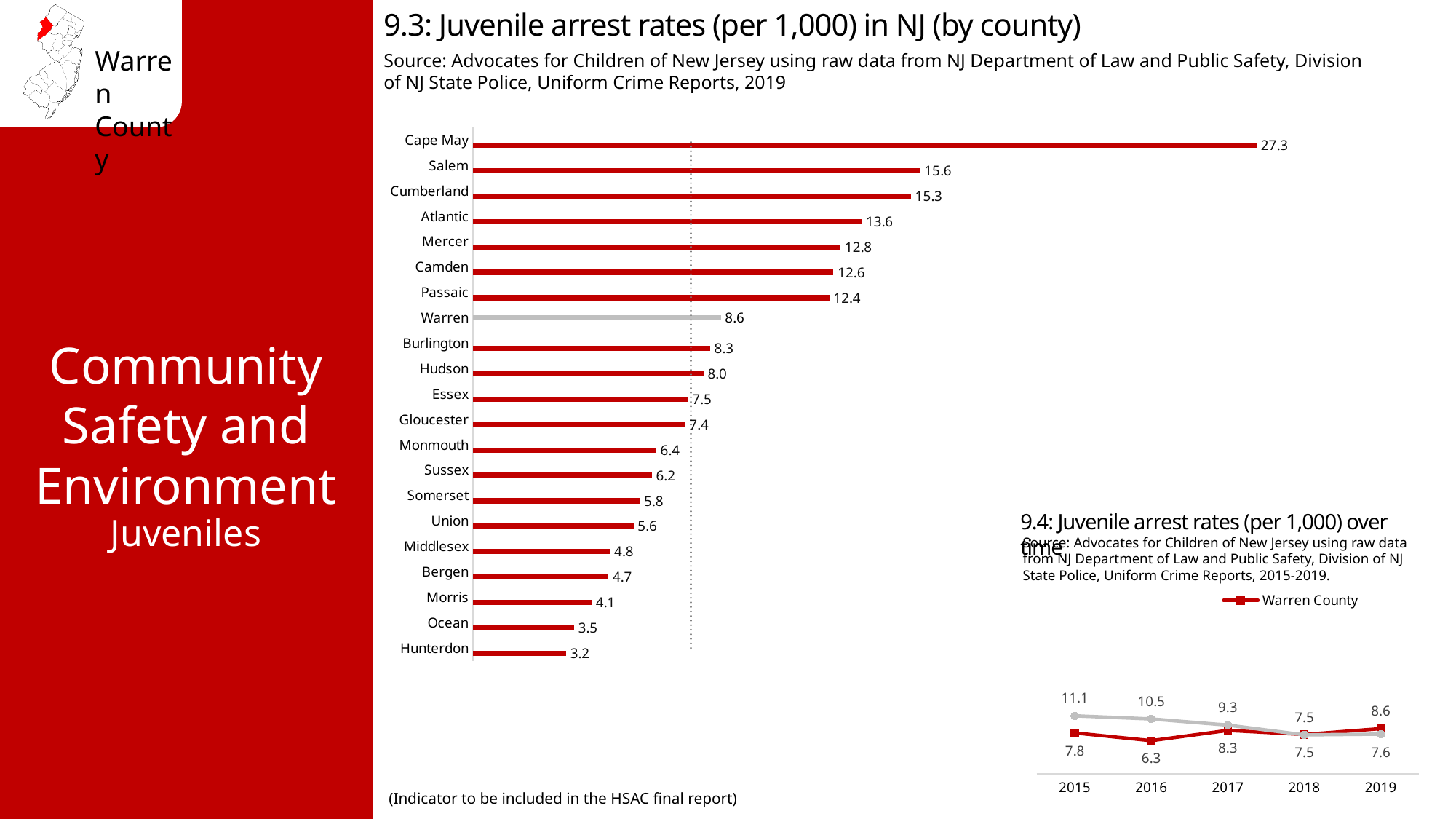
In chart 9.4 (Juvenile arrest rates over time), what is the Warren County value for 2019? 8.6 What kind of chart is chart 9.3 (Juvenile arrest rates by county)? Bar chart In chart 9.4 (Juvenile arrest rates over time), what is the Warren County value for 2016? 6.3 In chart 9.3 (Juvenile arrest rates by county), which county has the lowest juvenile arrest rate? Hunterdon In chart 9.3 (Juvenile arrest rates by county), which county has a higher rate, Mercer or Passaic? Mercer In chart 9.3 (Juvenile arrest rates by county), how many counties are shown? 21 In chart 9.3 (Juvenile arrest rates by county), what is the value for Cape May? 27.3 In chart 9.3 (Juvenile arrest rates by county), what is the juvenile arrest rate for Warren? 8.6 In chart 9.4 (Juvenile arrest rates over time), how many years are shown on the x axis? 5 In chart 9.3 (Juvenile arrest rates by county), which county has the highest juvenile arrest rate? Cape May In chart 9.3 (Juvenile arrest rates by county), what is the difference between the values for Salem and Cumberland? 0.3 In chart 9.4 (Juvenile arrest rates over time), in which year was the Warren County rate lowest? 2016